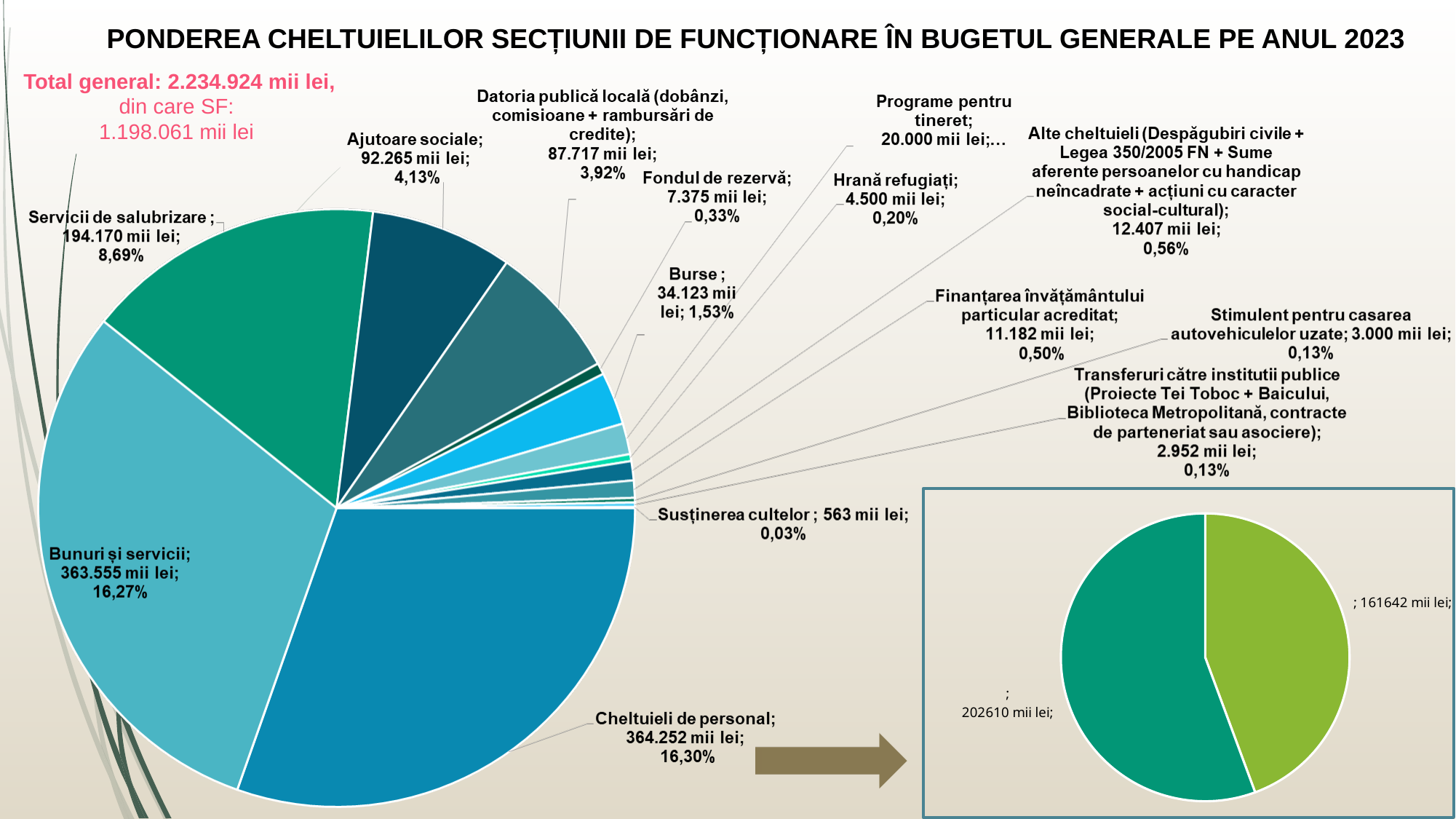
In the main pie chart, what is the difference between the values for Cheltuieli de personal and Bunuri și servicii? 697 mii lei How many slices does the small pie chart in the bottom-right box have? 2 In the main pie chart, what is the value for Bunuri și servicii? 363.555 mii lei In the small pie chart in the bottom-right box, what is the value of the larger slice? 202610 mii lei In the main pie chart, which is larger: Ajutoare sociale or Datoria publică locală? Ajutoare sociale In the main pie chart, what percentage share is shown for Hrană refugiați? 0,20% In the main pie chart, which category has the smallest share? Susținerea cultelor In the main pie chart, which category has the largest share according to the labels? Cheltuieli de personal In the main pie chart, what is the value for Burse? 34.123 mii lei In the main pie chart, what percentage share is shown for Servicii de salubrizare? 8,69% What type of chart is the large chart on the left of the slide? Pie chart What is the 'Total general' value stated at the top left of the slide? 2.234.924 mii lei